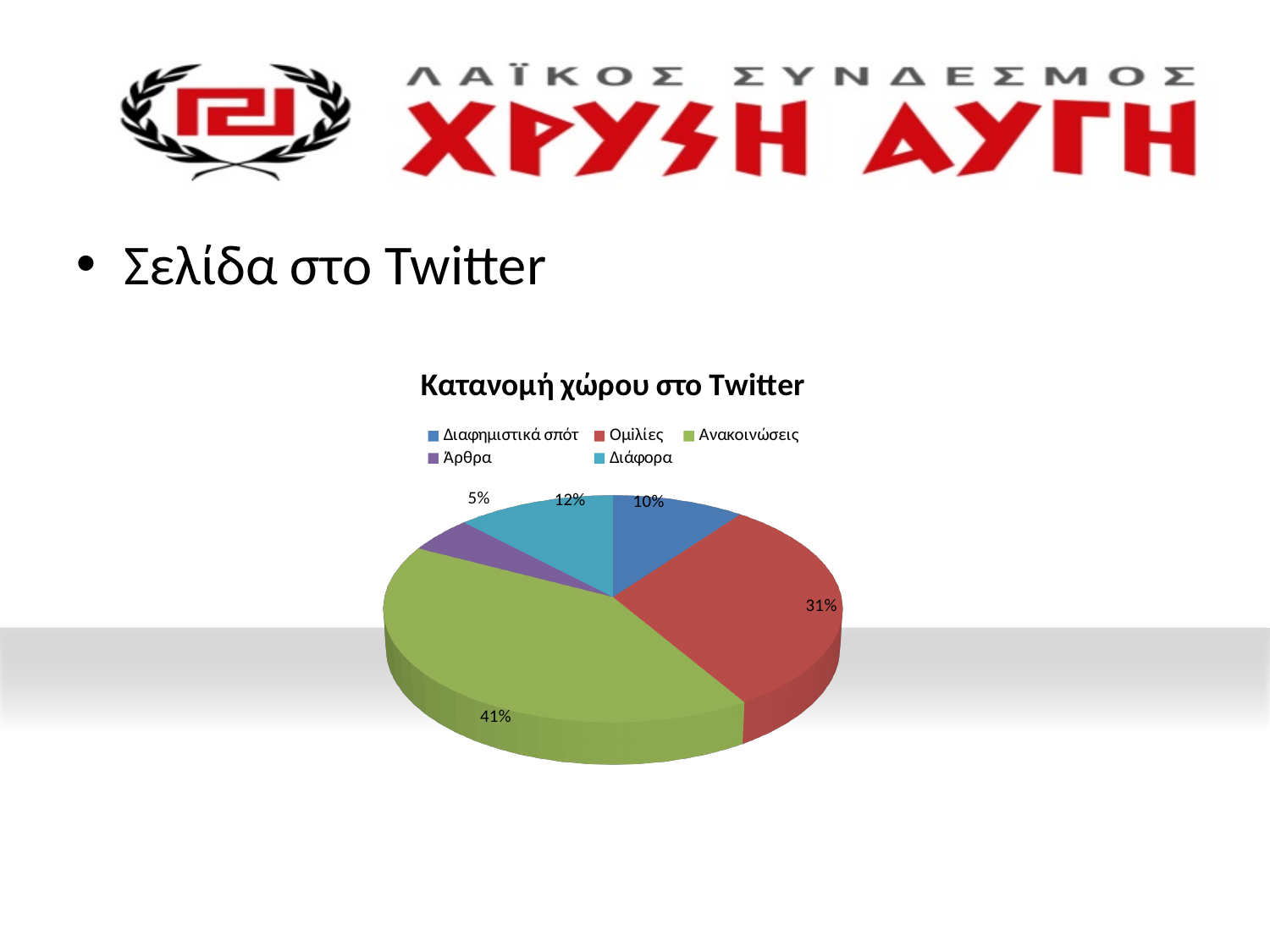
What kind of chart is shown on the slide? pie chart How many categories does the pie chart show? 5 What share of the pie does Άρθρα have? 5% What share of the pie does Ομιλίες have? 31% What is the title of the chart? Κατανομή χώρου στο Twitter What share of the pie does Ανακοινώσεις have? 41% Which category has the largest slice of the pie? Ανακοινώσεις Which category has the smallest slice of the pie? Άρθρα Which is larger, the share for Διάφορα or the share for Διαφημιστικά σπότ? Διάφορα What is the difference in percentage points between Ανακοινώσεις and Ομιλίες? 10